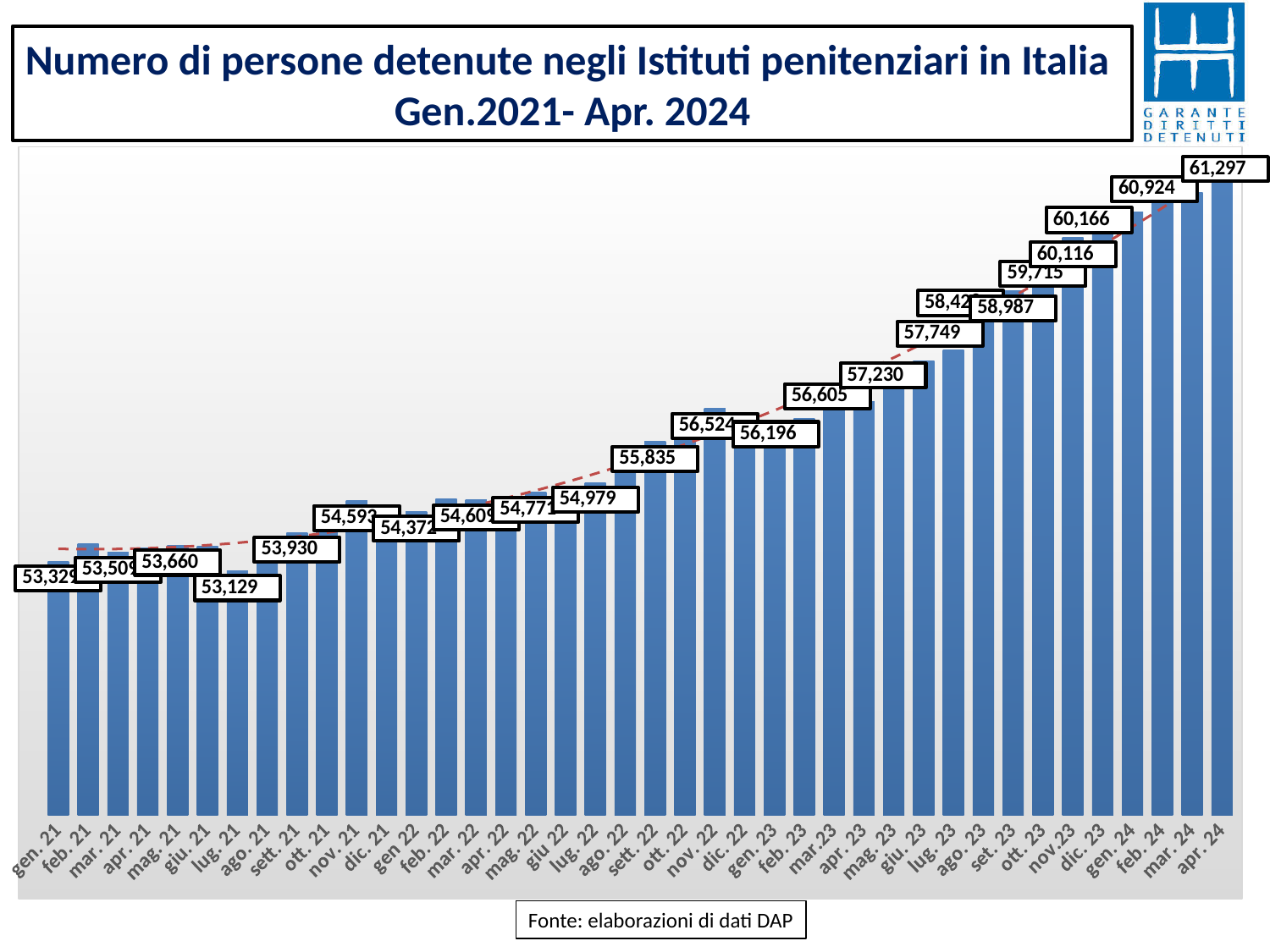
What is the lowest value labelled on the chart? 53,129 How many months (categories) are plotted along the x axis? 40 Do the values generally rise or fall from gen. 21 to apr. 24? Rise What is the difference between the value for apr. 24 (61,297) and the value for gen. 21 (53,329)? 7,968 Which month has the highest number of detained persons? apr. 24 What is the value shown for gen. 21? 53,329 What kind of chart is shown on the slide? Bar chart What is the value shown for apr. 24? 61,297 What source is cited below the chart? Fonte: elaborazioni di dati DAP Which is larger, the value for gen. 21 or the value for lug. 21? gen. 21 What is the title of the chart? Numero di persone detenute negli Istituti penitenziari in Italia Gen.2021- Apr. 2024 Which is larger, the value for apr. 24 or the value for gen. 21? apr. 24